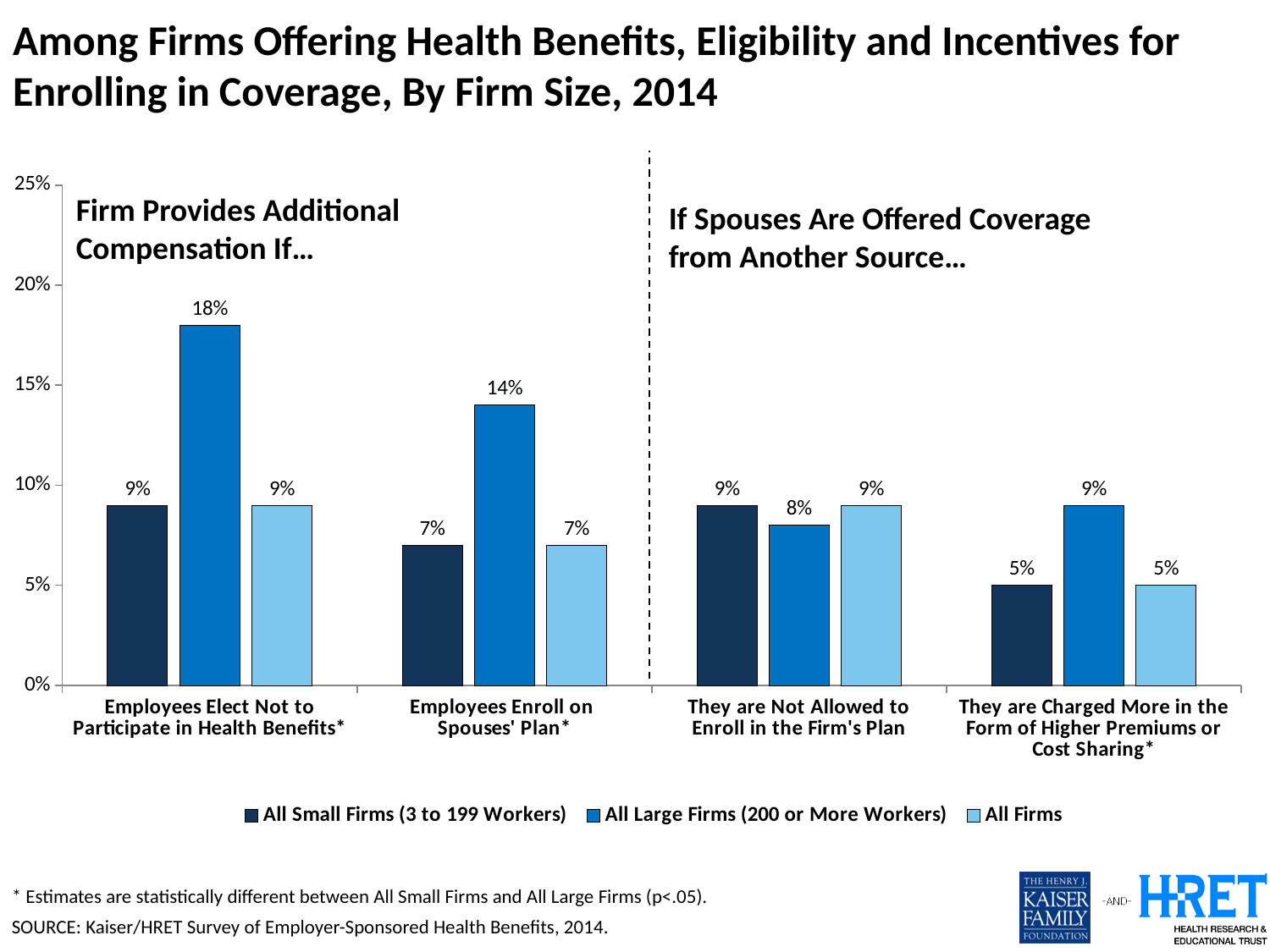
What kind of chart is shown on the slide? Bar chart What is the difference between All Large Firms and All Firms in the 'Employees Enroll on Spouses' Plan*' category? 7% What is the value for All Large Firms (200 or More Workers) in the 'Employees Elect Not to Participate in Health Benefits*' category? 18% What is the value for All Large Firms (200 or More Workers) in the 'They are Charged More in the Form of Higher Premiums or Cost Sharing*' category? 9% In the 'They are Not Allowed to Enroll in the Firm's Plan' category, which is larger: All Small Firms or All Large Firms? All Small Firms What is the value for All Firms in the 'They are Not Allowed to Enroll in the Firm's Plan' category? 9% What is the value for All Small Firms (3 to 199 Workers) in the 'Employees Enroll on Spouses' Plan*' category? 7% Which category has the lowest value for All Small Firms (3 to 199 Workers)? They are Charged More in the Form of Higher Premiums or Cost Sharing* Which category has the highest value for All Large Firms (200 or More Workers)? Employees Elect Not to Participate in Health Benefits* How many series does the legend list? 3 What is the difference between All Large Firms and All Small Firms in the 'Employees Elect Not to Participate in Health Benefits*' category? 9% How many categories are shown on the x axis? 4